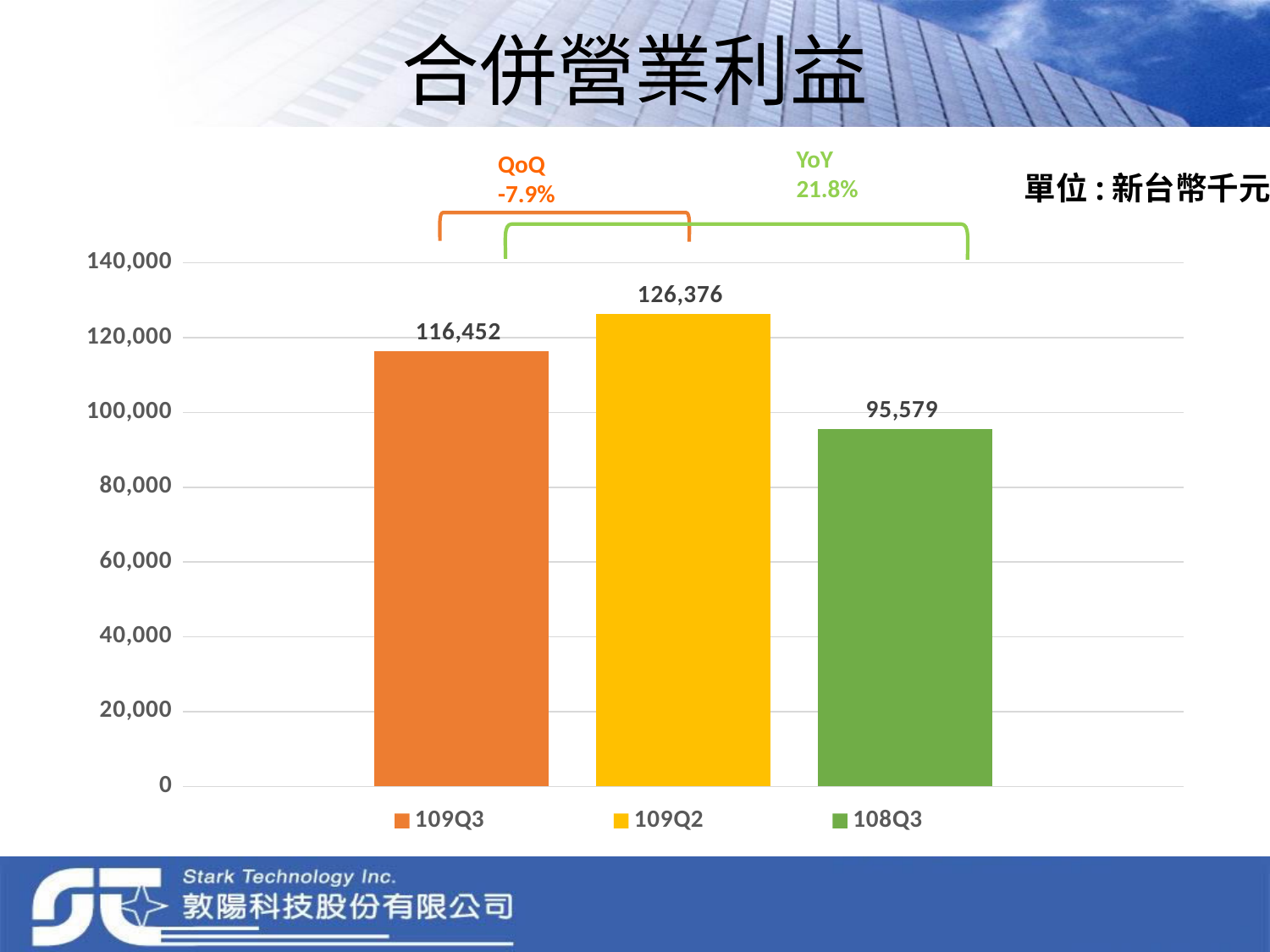
What is the value for 108Q3? 95,579 Which period has the lowest value? 108Q3 Which is larger, the value for 109Q3 or the value for 108Q3? 109Q3 What is the difference between the values for 109Q3 and 108Q3? 20,873 What is the value for 109Q3? 116,452 What is the value for 109Q2? 126,376 What is the difference between the values for 109Q2 and 109Q3? 9,924 Which period has the highest value? 109Q2 What QoQ percentage change is shown above the chart? -7.9% Is the value for 108Q3 greater or less than 100,000? less What kind of chart is shown on the slide? bar chart How many bars are shown in the chart? 3